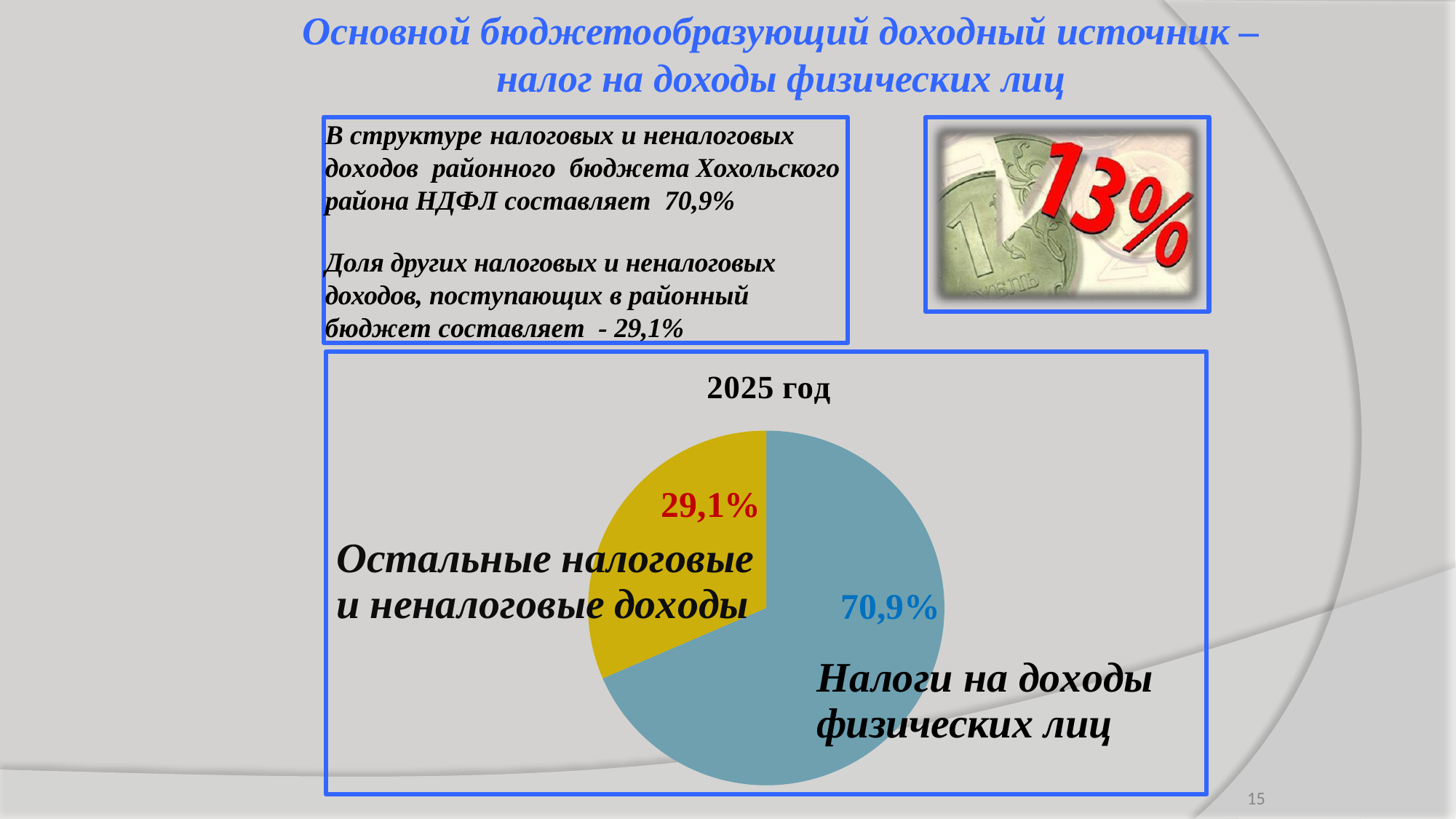
What colour is the "Налоги на доходы физических лиц" slice of the pie chart? blue Which is larger: the share for "Налоги на доходы физических лиц" or the share for "Остальные налоговые и неналоговые доходы"? Налоги на доходы физических лиц How many slices does the pie chart have? 2 Which slice of the pie chart is the smallest? Остальные налоговые и неналоговые доходы What share of the pie does "Остальные налоговые и неналоговые доходы" have? 29,1% What share of the pie does "Налоги на доходы физических лиц" have? 70,9% Which slice of the pie chart is the largest? Налоги на доходы физических лиц What is the title of the pie chart? 2025 год What is the difference in percentage points between the "Налоги на доходы физических лиц" slice and the "Остальные налоговые и неналоговые доходы" slice? 41,8 What kind of chart is shown on the slide? pie chart What is the total of the two slices shown in the pie chart? 100%